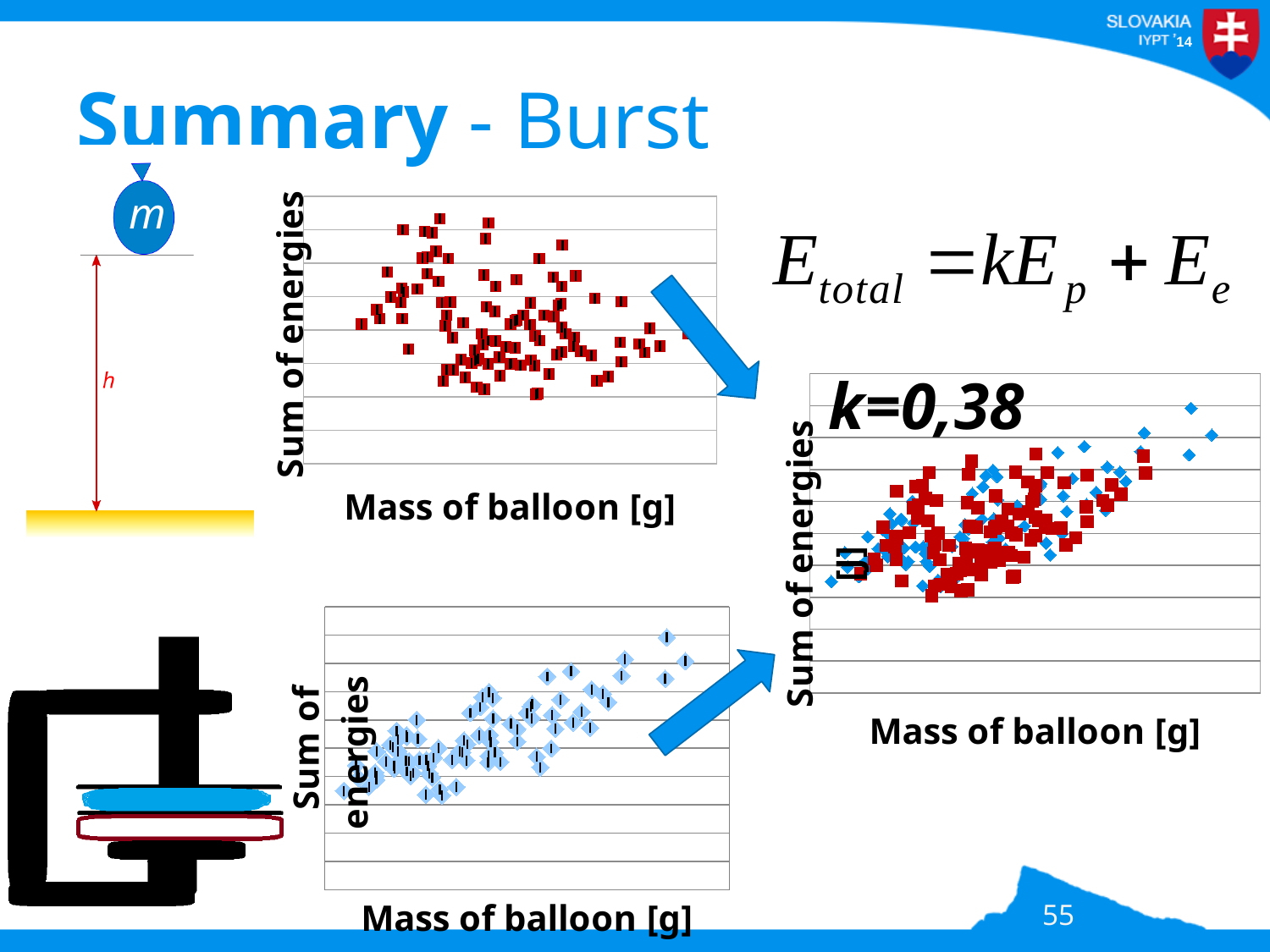
In the bottom chart with blue markers, do the values rise or fall as mass of balloon increases? rise What is the x-axis title of the top-left chart? Mass of balloon [g] What kind of chart is the top-left chart with red markers? scatter chart What is the y-axis title of the right-hand chart labelled k=0,38? Sum of energies [J] In the right-hand chart labelled k=0,38, do the values rise or fall as mass of balloon increases? rise What kind of chart is the bottom chart with blue markers? scatter chart What kind of chart is the right-hand chart labelled k=0,38? scatter chart